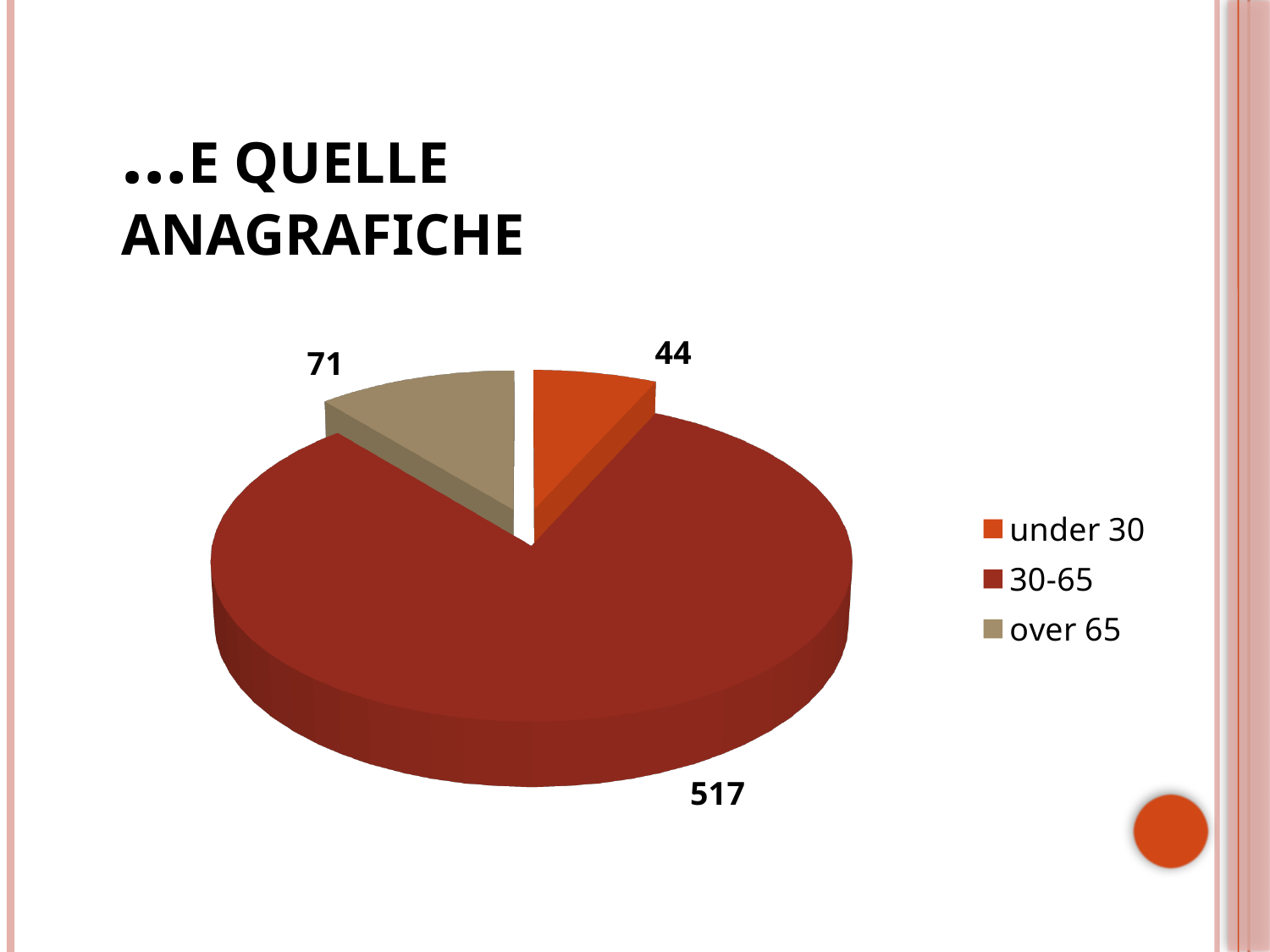
What is the value for the under 30 slice? 44 Which colour is used for the 30-65 slice? dark red Which category has the smallest slice? under 30 What is the value for the over 65 slice? 71 What is the value for the 30-65 slice? 517 What is the difference between the over 65 value and the under 30 value? 27 How many slices does the pie chart have? 3 What is the total of all slices in the pie chart? 632 What is the difference between the 30-65 value and the over 65 value? 446 What kind of chart is shown on the slide? pie chart Which category has the largest slice? 30-65 Which is larger, the over 65 slice or the under 30 slice? over 65